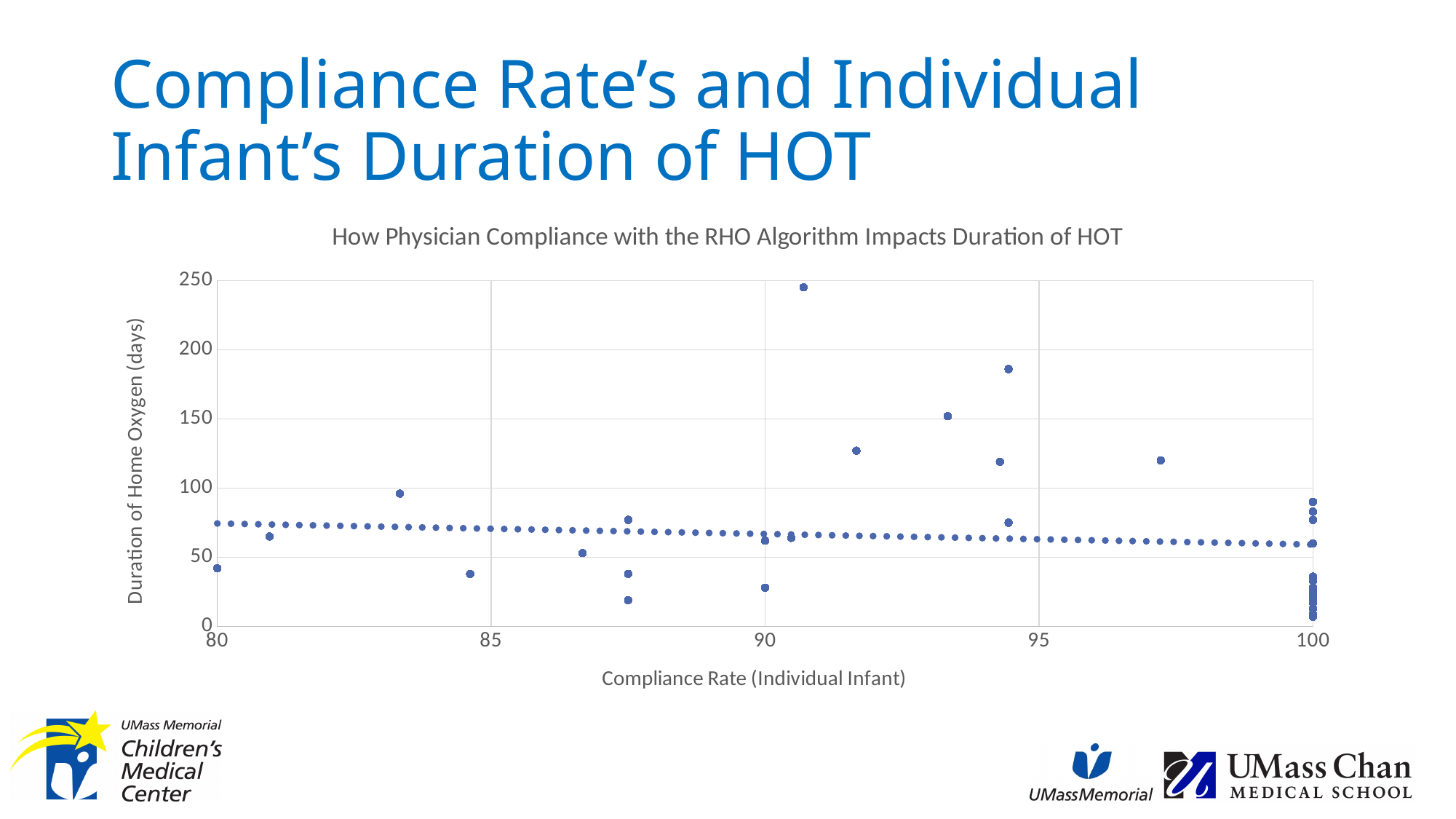
Is the duration of home oxygen for the point plotted between compliance rates 80 and 85 with the highest value greater or less than 50 days? greater Is the duration of home oxygen for the point at a compliance rate of 90 with the lowest value greater or less than 50 days? less Is the duration of home oxygen for the point plotted between compliance rates 95 and 100 greater or less than 100 days? greater What kind of chart is shown on the slide? Scatter plot Does the dotted trend line rise or fall as the compliance rate increases from 80 to 100? Falls Which has the higher duration of home oxygen: the highest point near a compliance rate of 90.7 or the highest point near a compliance rate of 94.5? The point near 90.7 What is the label of the vertical axis of the chart? Duration of Home Oxygen (days) What is the title of the chart? How Physician Compliance with the RHO Algorithm Impacts Duration of HOT